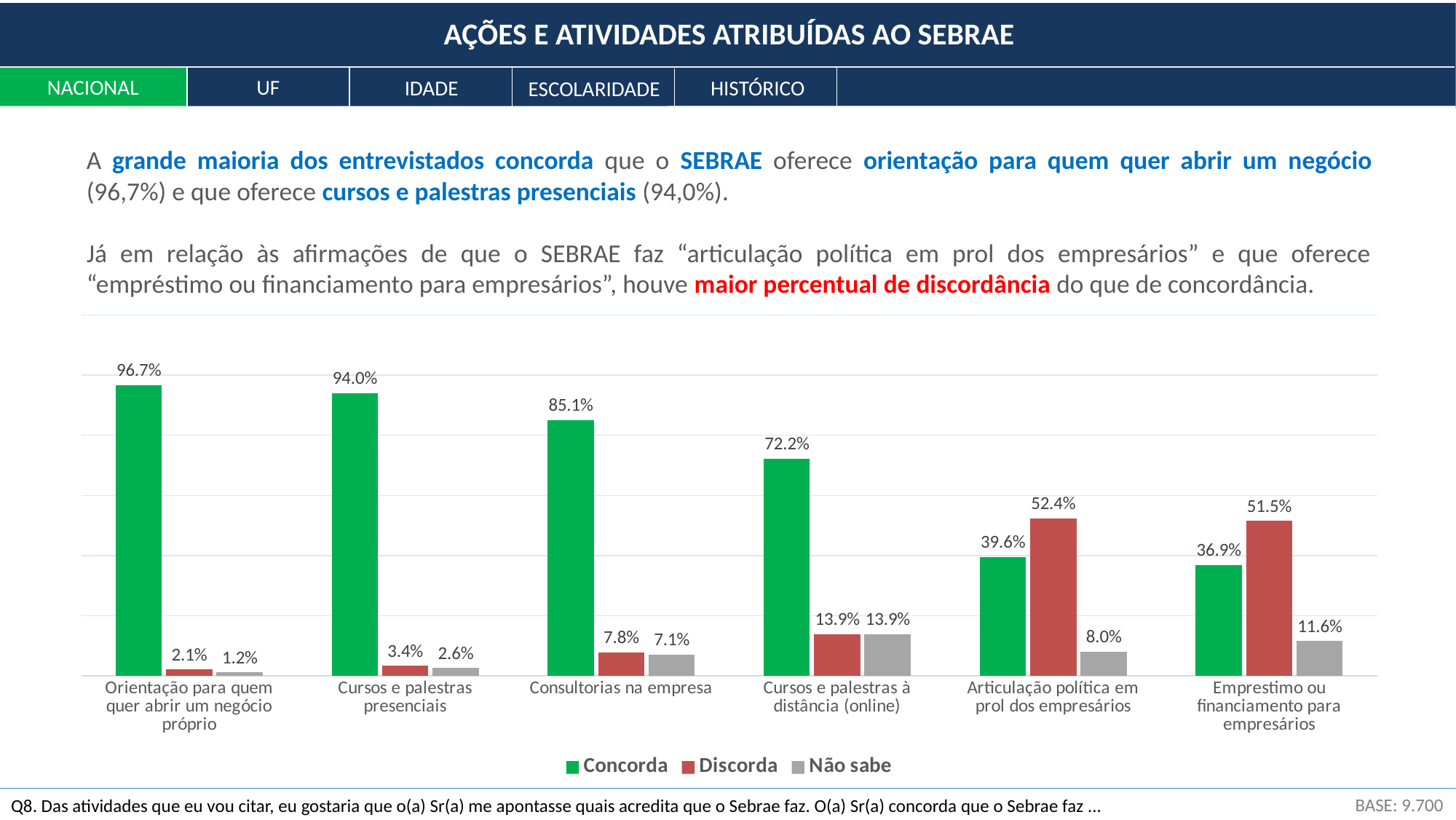
What is the Discorda value for "Articulação política em prol dos empresários"? 52.4% How many series does the legend list? 3 What kind of chart is shown on the slide? Bar chart For "Articulação política em prol dos empresários", which is larger: Concorda or Discorda? Discorda What is the difference between the Concorda values for "Orientação para quem quer abrir um negócio próprio" and "Cursos e palestras presenciais"? 2.7% Do the Concorda values rise or fall from left to right across the categories? Fall What is the Concorda value for "Consultorias na empresa"? 85.1% Which colour represents the Discorda series in the legend? Red What is the Não sabe value for "Emprestimo ou financiamento para empresários"? 11.6% Which category has the lowest Concorda value? Emprestimo ou financiamento para empresários Which category has the highest Concorda value? Orientação para quem quer abrir um negócio próprio How many categories are shown on the x axis? 6